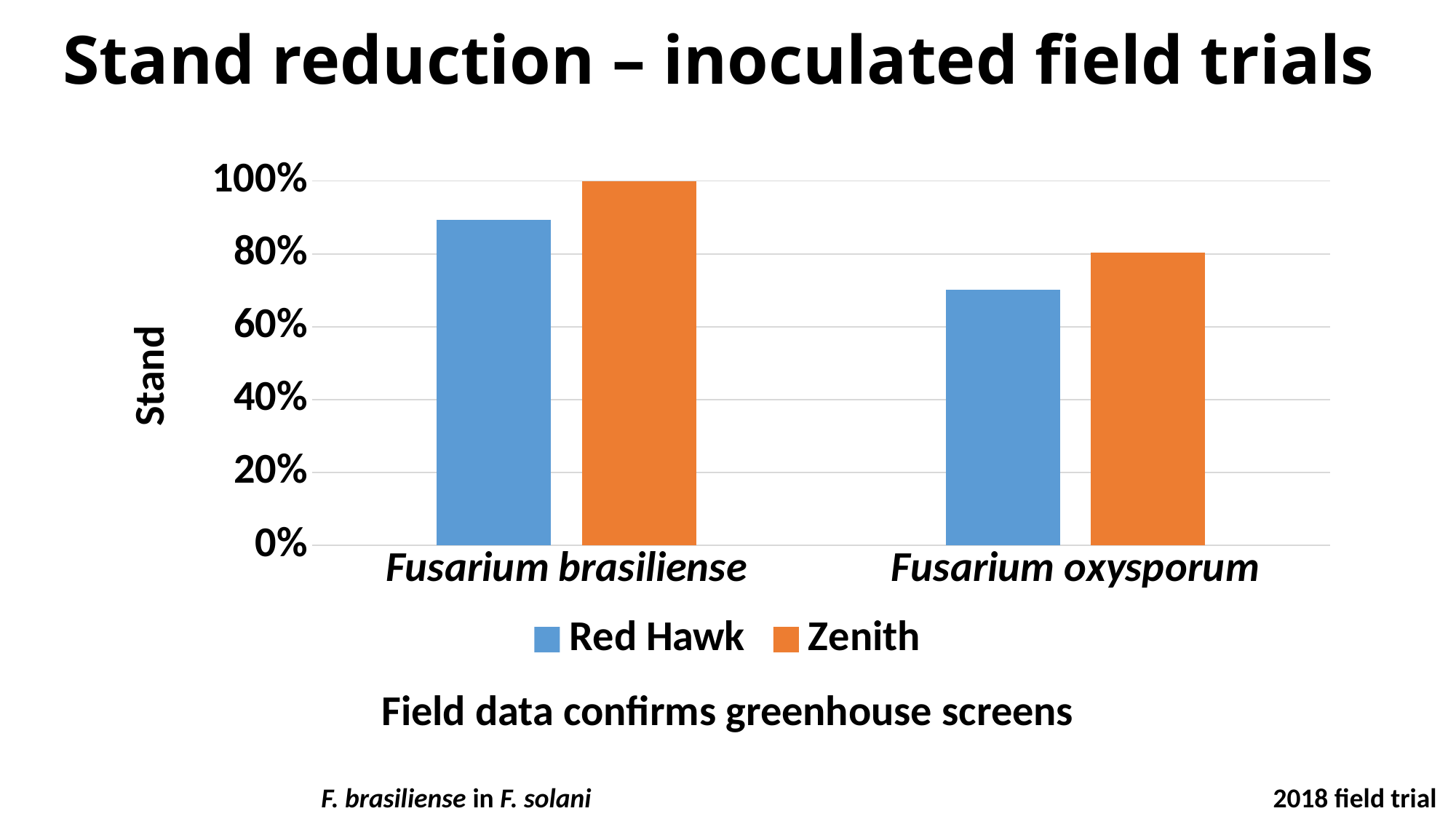
Under Fusarium brasiliense, which variety has the higher Stand, Red Hawk or Zenith? Zenith How many categories are shown on the x axis? 2 Under Fusarium oxysporum, which variety has the higher Stand, Red Hawk or Zenith? Zenith Which bar is the lowest on the chart? Red Hawk under Fusarium oxysporum What is the label on the vertical axis? Stand Is the value for Red Hawk under Fusarium oxysporum greater or less than 80%? less Is the value for Zenith under Fusarium oxysporum greater or less than 60%? greater Which bar is the highest on the chart? Zenith under Fusarium brasiliense Is the value for Red Hawk under Fusarium brasiliense greater or less than 80%? greater How many series does the legend list? 2 What kind of chart is shown on the slide? bar chart